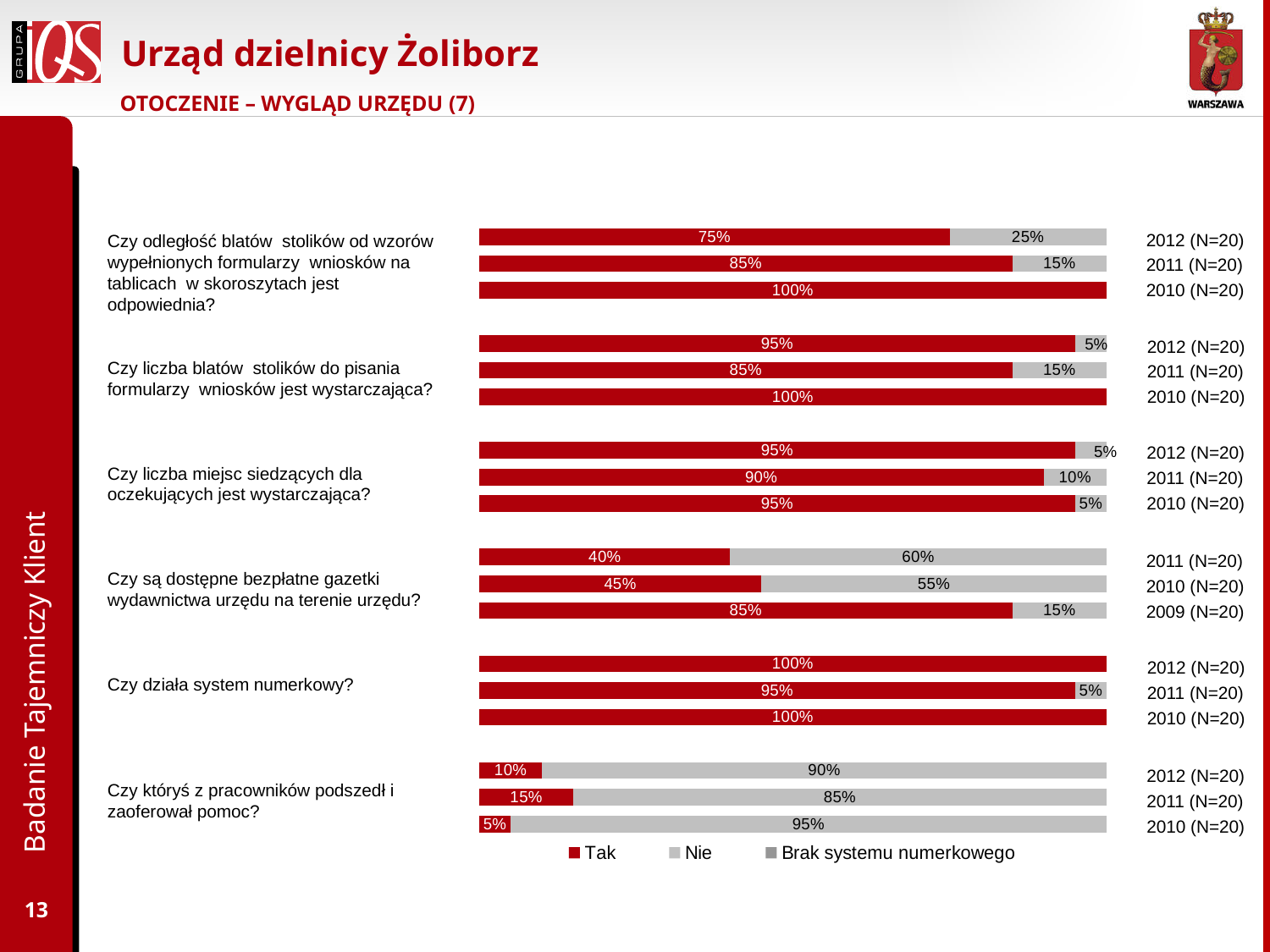
For the question 'Czy któryś z pracowników podszedł i zaoferował pomoc?', which year has the lowest 'Tak' value? 2010 (N=20) How many series does the legend list? 3 What is the 'Nie' value for 2011 (N=20) for the question 'Czy liczba blatów stolików do pisania formularzy wniosków jest wystarczająca?' 15% What is the 'Tak' value for 2012 (N=20) for the question 'Czy odległość blatów stolików od wzorów wypełnionych formularzy wniosków na tablicach w skoroszytach jest odpowiednia?' 75% For the question 'Czy są dostępne bezpłatne gazetki wydawnictwa urzędu na terenie urzędu?', what is the difference between the 'Tak' values for 2009 (N=20) and 2011 (N=20)? 45% For the question 'Czy są dostępne bezpłatne gazetki wydawnictwa urzędu na terenie urzędu?', which year has the highest 'Tak' value? 2009 (N=20) For the question 'Czy działa system numerkowy?', is the 'Tak' value for 2011 (N=20) larger or smaller than for 2012 (N=20)? Smaller What is the 'Nie' value for 2012 (N=20) for the question 'Czy któryś z pracowników podszedł i zaoferował pomoc?' 90% What is the third legend entry in the chart? Brak systemu numerkowego What is the 'Tak' value for 2011 (N=20) for the question 'Czy liczba miejsc siedzących dla oczekujących jest wystarczająca?' 90% How many years are shown for the question 'Czy działa system numerkowy?' 3 What kind of chart is shown on the slide? Stacked bar chart